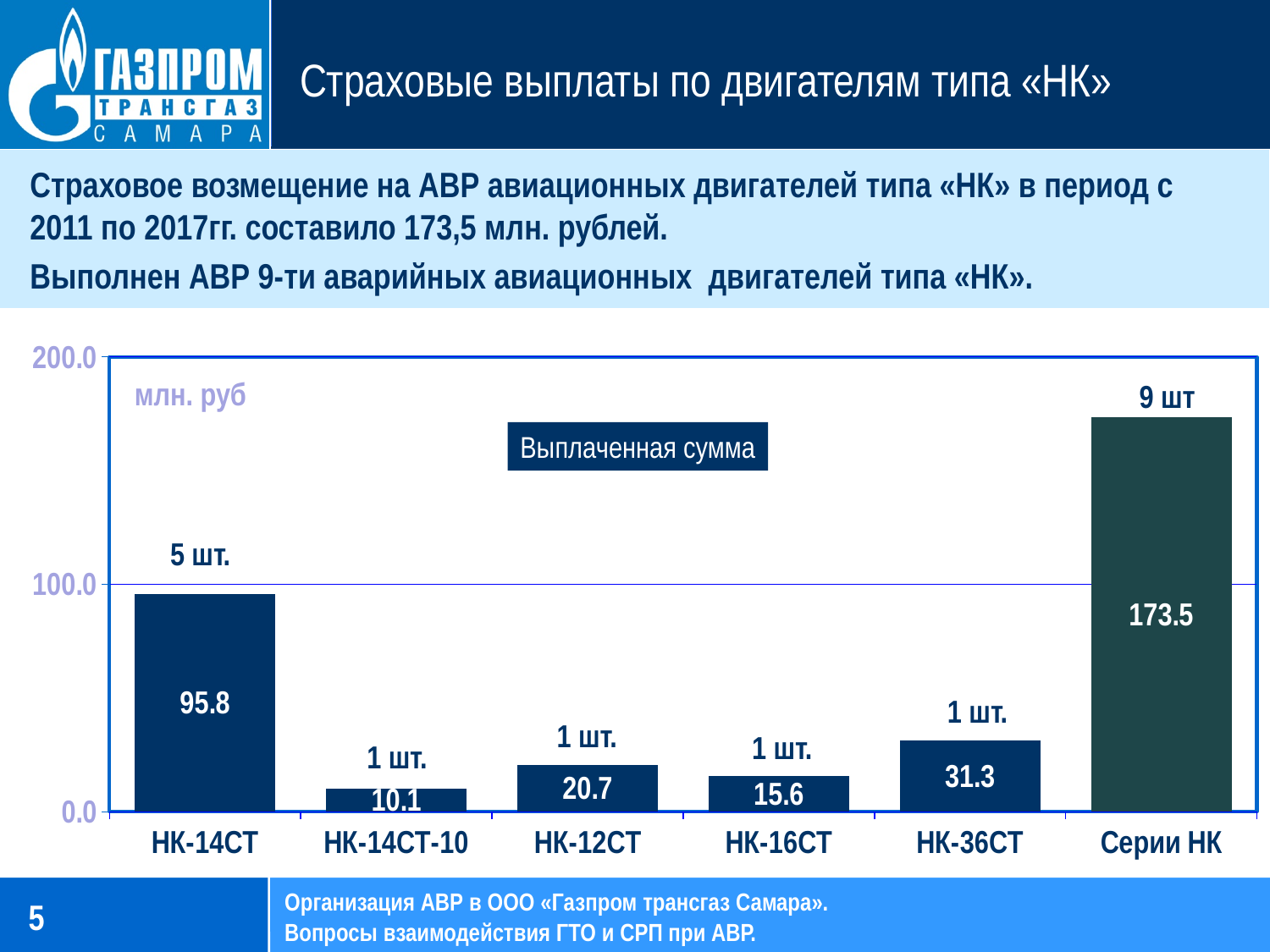
How many units (шт.) are labelled above the НК-14СТ bar? 5 шт. Which category has the highest value? Серии НК What is the legend entry of the chart? Выплаченная сумма Which is larger, the value for НК-36СТ or the value for НК-12СТ? НК-36СТ What is the value for НК-14СТ? 95.8 How many categories are shown on the x axis? 6 What is the difference between the values for НК-12СТ and НК-16СТ? 5.1 What is the value for НК-36СТ? 31.3 Which category has the lowest value? НК-14СТ-10 What is the value for Серии НК? 173.5 What kind of chart is shown on the slide? bar chart Is the value for НК-14СТ greater or less than 100.0? less